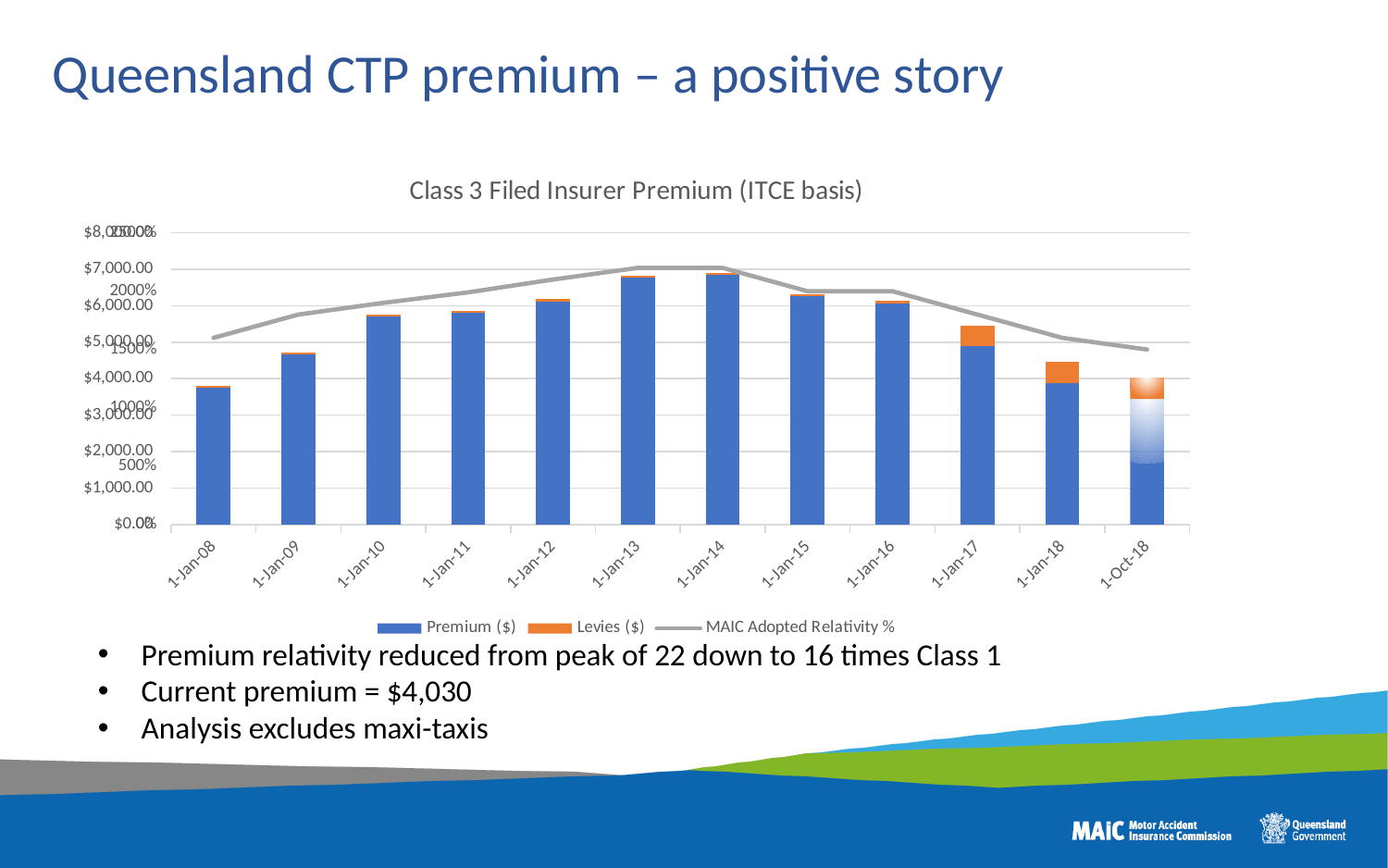
How many series does the chart legend list? 3 Do the bar totals rise or fall from 1-Jan-14 to 1-Jan-18? fall Is the total bar for 1-Jan-18 greater or less than $4,000.00? greater Is the total bar for 1-Jan-13 greater or less than $6,000.00? greater Which has the taller total bar, 1-Jan-13 or 1-Jan-08? 1-Jan-13 How many dates are shown along the x axis of the chart? 12 Is the total bar for 1-Jan-09 greater or less than $5,000.00? less Which series is plotted as a line in the chart? MAIC Adopted Relativity % Which has the taller total bar, 1-Jan-16 or 1-Jan-17? 1-Jan-16 What is the title of the chart? Class 3 Filed Insurer Premium (ITCE basis) What kind of chart is shown on the slide? Stacked bar chart with a line